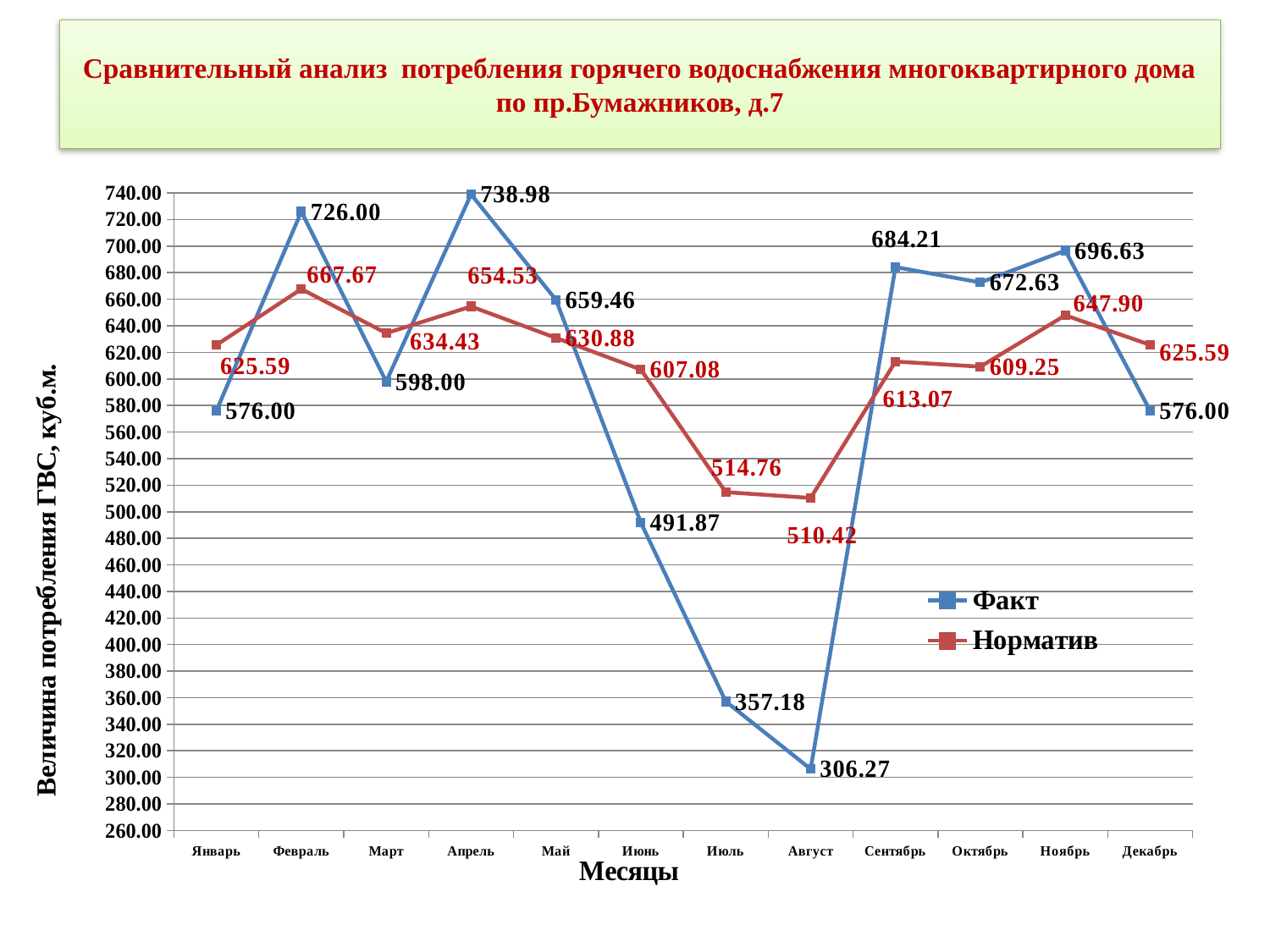
In which month is the Норматив value the highest? Февраль What is the Норматив value for Июль? 514.76 How many months are shown on the x axis? 12 What is the Факт value for Апрель? 738.98 What is the difference between the Норматив and Факт values in Август? 204.15 Which is larger in Сентябрь, the Факт value or the Норматив value? Факт What type of chart is shown on the slide? Line chart How many series does the legend list? 2 In which month is the Факт value the lowest? Август Does the Факт value rise or fall from Май to Август? Fall What is the label of the y axis? Величина потребления ГВС, куб.м. What is the Факт value for Август? 306.27